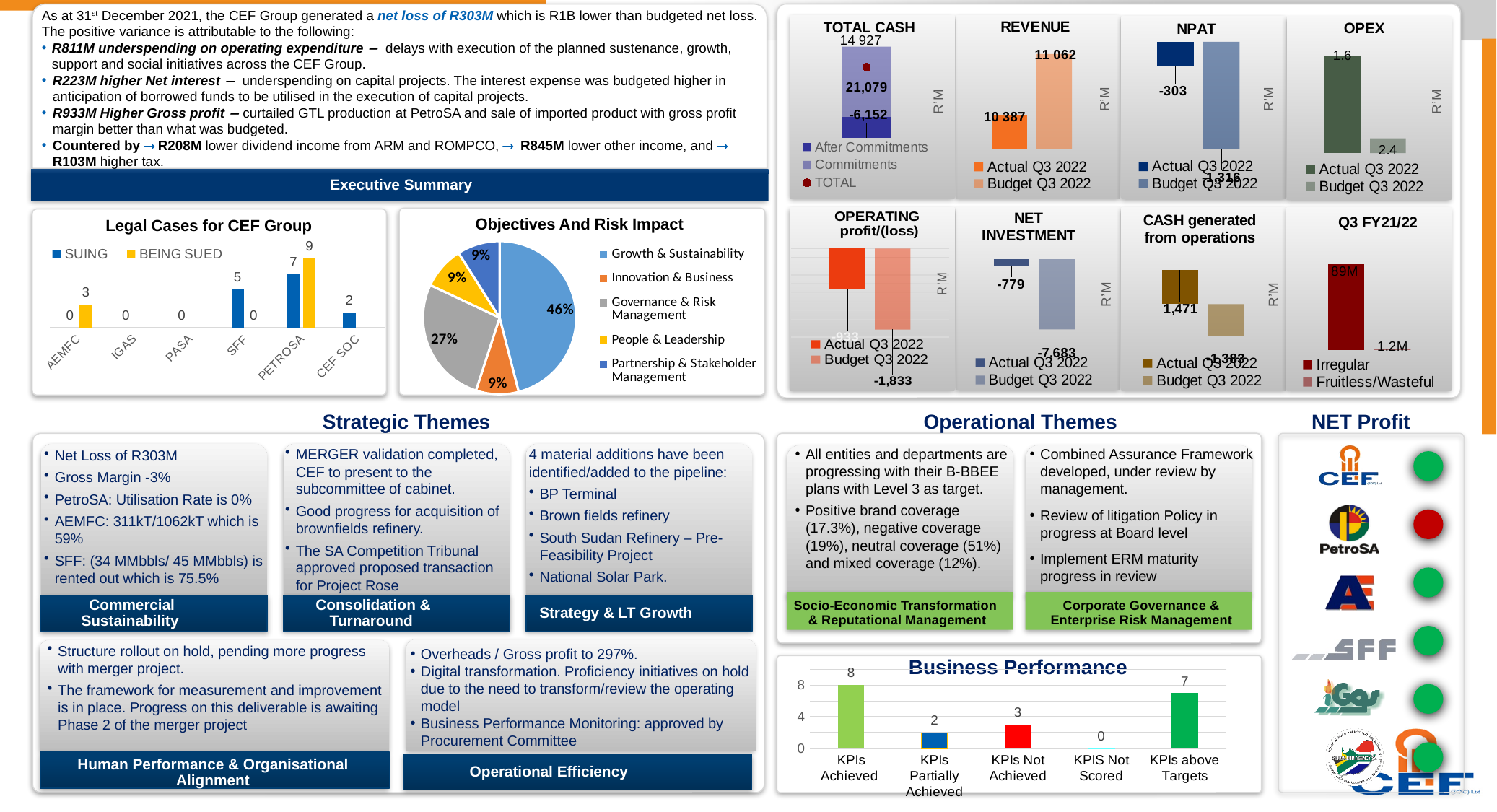
In the Objectives And Risk Impact pie chart, what share does Governance & Risk Management have? 27% In the TOTAL CASH chart, what is the Commitments value? 21,079 How many series does the legend of the Legal Cases for CEF Group chart list? 2 In the Legal Cases for CEF Group chart, what is the BEING SUED value for PETROSA? 9 In the REVENUE chart, what is the Budget Q3 2022 value? 11 062 In the Business Performance chart, what is the difference between KPIs Achieved and KPIs above Targets? 1 In the Business Performance chart, which category has the lowest value? KPIS Not Scored In the Business Performance chart, how many KPIs were achieved? 8 How many categories are shown on the x axis of the Business Performance chart? 5 What kind of chart is the Objectives And Risk Impact chart? Pie chart In the Legal Cases for CEF Group chart, which entity has the highest SUING value? PETROSA